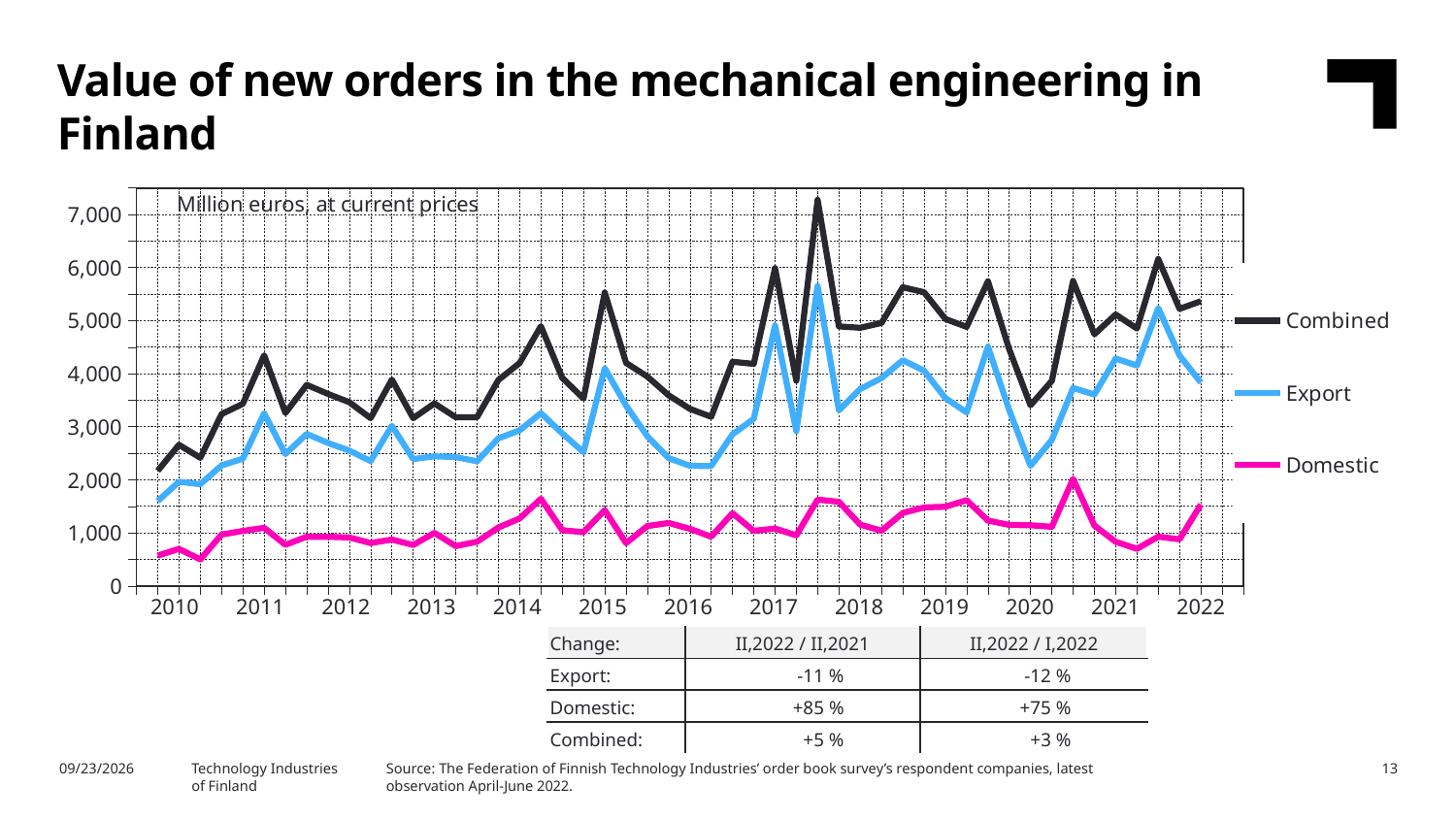
In the table below the chart, what is the Domestic change for II,2022 / II,2021? +85 % Is the first value of the Export series in 2010 greater or less than 2,000? less Which series are listed in the legend? Combined, Export, Domestic Does the Combined series rise or fall overall from 2010 to 2022? rise Is the peak value of the Combined series in 2017 greater or less than 6,000? greater Is the value of the Domestic series ever greater or less than 3,000? less Which series has the lowest values throughout the chart? Domestic Which series has the highest values throughout the chart? Combined How many series does the legend list? 3 What unit is stated for the values in the chart? Million euros, at current prices What kind of chart is shown on the slide? Line chart How many years are labelled on the x axis? 13